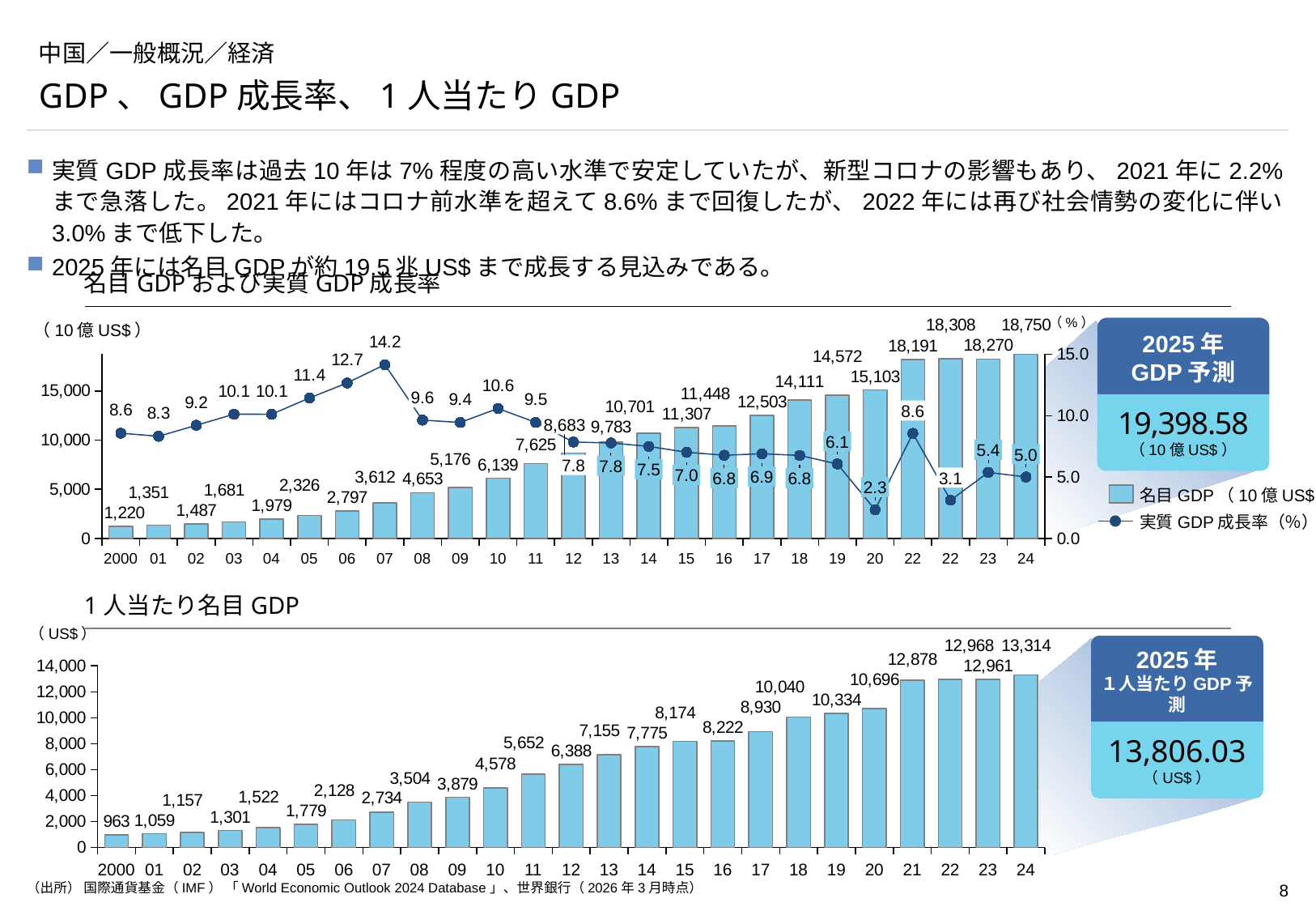
In the top chart (名目GDPおよび実質GDP成長率), what is the 2025 GDP forecast shown in the box on the right? 19,398.58 In the bottom chart (1人当たり名目GDP), which year has the highest value? 2024 In the top chart (名目GDPおよび実質GDP成長率), how many series does the legend list? 2 In the top chart (名目GDPおよび実質GDP成長率), in which year is the real GDP growth rate highest? 2007 In the top chart (名目GDPおよび実質GDP成長率), what is the difference between the nominal GDP in 2024 and in 2023? 480 In the bottom chart (1人当たり名目GDP), which year has the lowest value? 2000 In the bottom chart (1人当たり名目GDP), which is larger, the value for 2022 or the value for 2023? 2022 In the top chart (名目GDPおよび実質GDP成長率), what is the nominal GDP value for 2007? 3,612 In the top chart (名目GDPおよび実質GDP成長率), what is the real GDP growth rate for 2020? 2.3 In the top chart (名目GDPおよび実質GDP成長率), in which year is the real GDP growth rate lowest? 2020 What kind of chart is the bottom chart (1人当たり名目GDP)? Bar chart In the bottom chart (1人当たり名目GDP), what is the value for 2010? 4,578